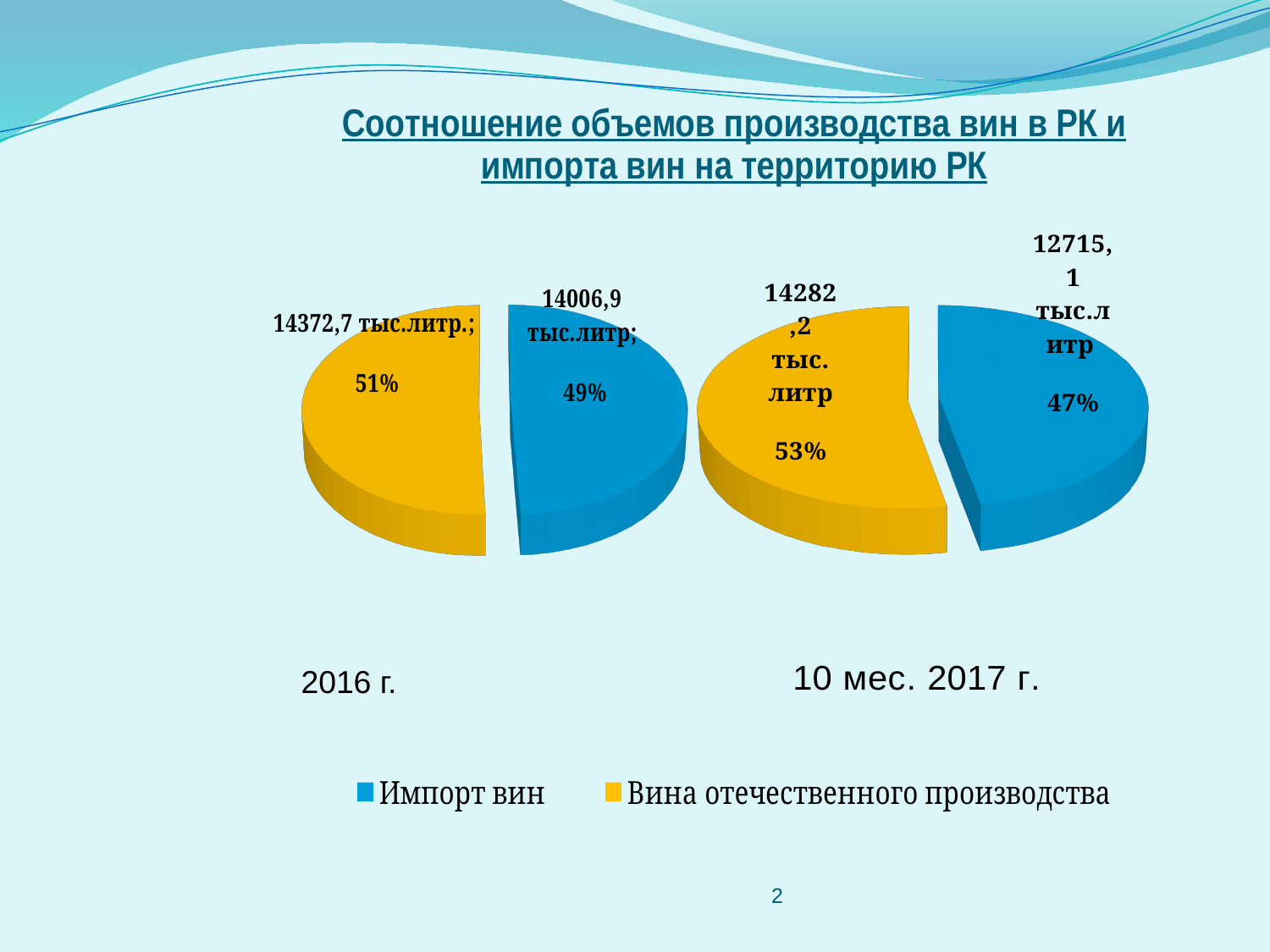
Which colour represents Импорт вин in the legend? blue How many series does the legend list? 2 In the 10 мес. 2017 г. pie chart, what is the value for Вина отечественного производства? 14282,2 тыс.литр In the 10 мес. 2017 г. pie chart, what is the difference between Вина отечественного производства and Импорт вин? 1567,1 тыс.литр In the 10 мес. 2017 г. pie chart, what is the value for Импорт вин? 12715,1 тыс.литр In the 2016 г. pie chart, what is the value for Импорт вин? 14006,9 тыс.литр In the 2016 г. pie chart, what share does Импорт вин have? 49% What type of chart is used on the slide? pie chart How many pie charts are shown on the slide? 2 In the 10 мес. 2017 г. pie chart, which slice is larger: Импорт вин or Вина отечественного производства? Вина отечественного производства In the 10 мес. 2017 г. pie chart, what share does Вина отечественного производства have? 53% In the 2016 г. pie chart, what is the value for Вина отечественного производства? 14372,7 тыс.литр.